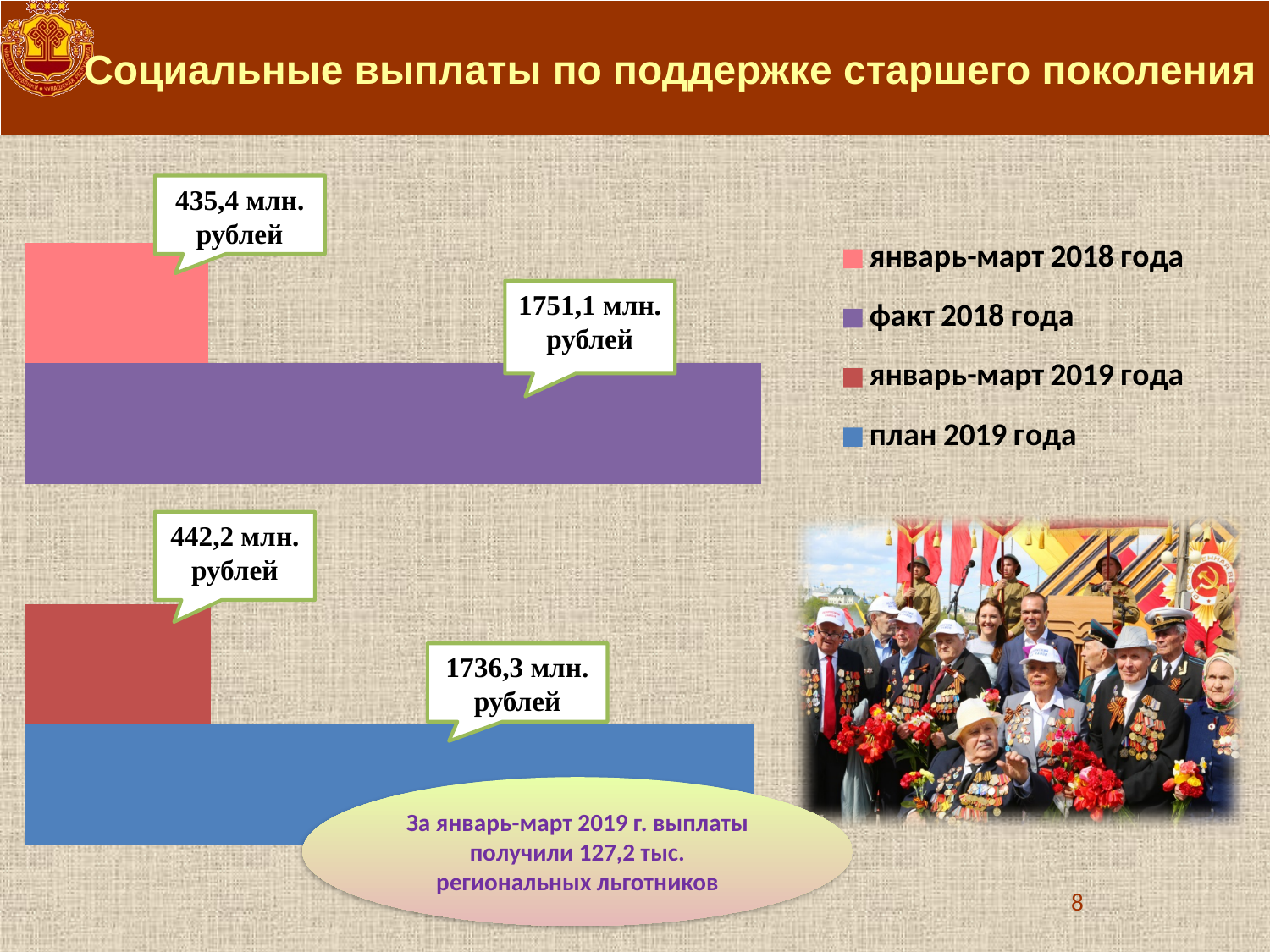
How many entries does the legend list? 4 How many bars are shown in the chart? 4 What is the value for факт 2018 года? 1751,1 млн. рублей Which is larger, факт 2018 года or план 2019 года? факт 2018 года What kind of chart is shown on the slide? bar chart Which category has the lowest value? январь-март 2018 года What is the difference between факт 2018 года and план 2019 года? 14,8 млн. рублей What is the value for январь-март 2019 года? 442,2 млн. рублей Which category has the highest value? факт 2018 года What is the value for январь-март 2018 года? 435,4 млн. рублей What is the value for план 2019 года? 1736,3 млн. рублей What is the difference between январь-март 2019 года and январь-март 2018 года? 6,8 млн. рублей